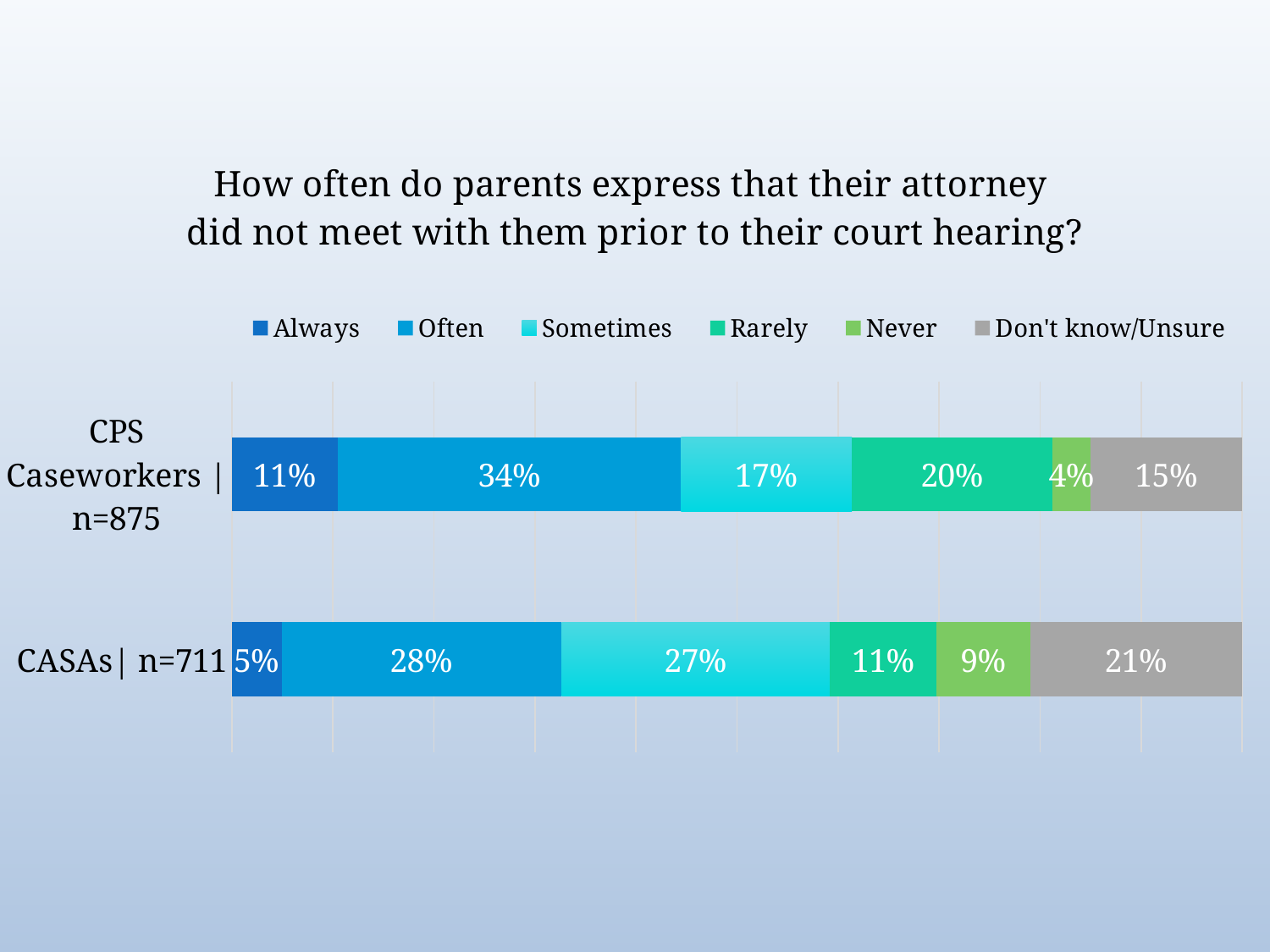
What percentage of CPS Caseworkers answered "Don't know/Unsure"? 15% Which response category has the smallest share among CASAs? Always What is the sample size (n) for the CASAs group? 711 What percentage of CPS Caseworkers answered "Often"? 34% What percentage of CASAs answered "Never"? 9% What is the difference between the "Rarely" percentages for CPS Caseworkers and CASAs? 9% What percentage of CASAs answered "Sometimes"? 27% How many groups (bars) are shown in the chart? 2 Which response category has the largest share among CPS Caseworkers? Often What kind of chart is shown on the slide? Stacked bar chart How many series does the legend list? 6 Which group has a higher percentage for "Don't know/Unsure", CPS Caseworkers or CASAs? CASAs